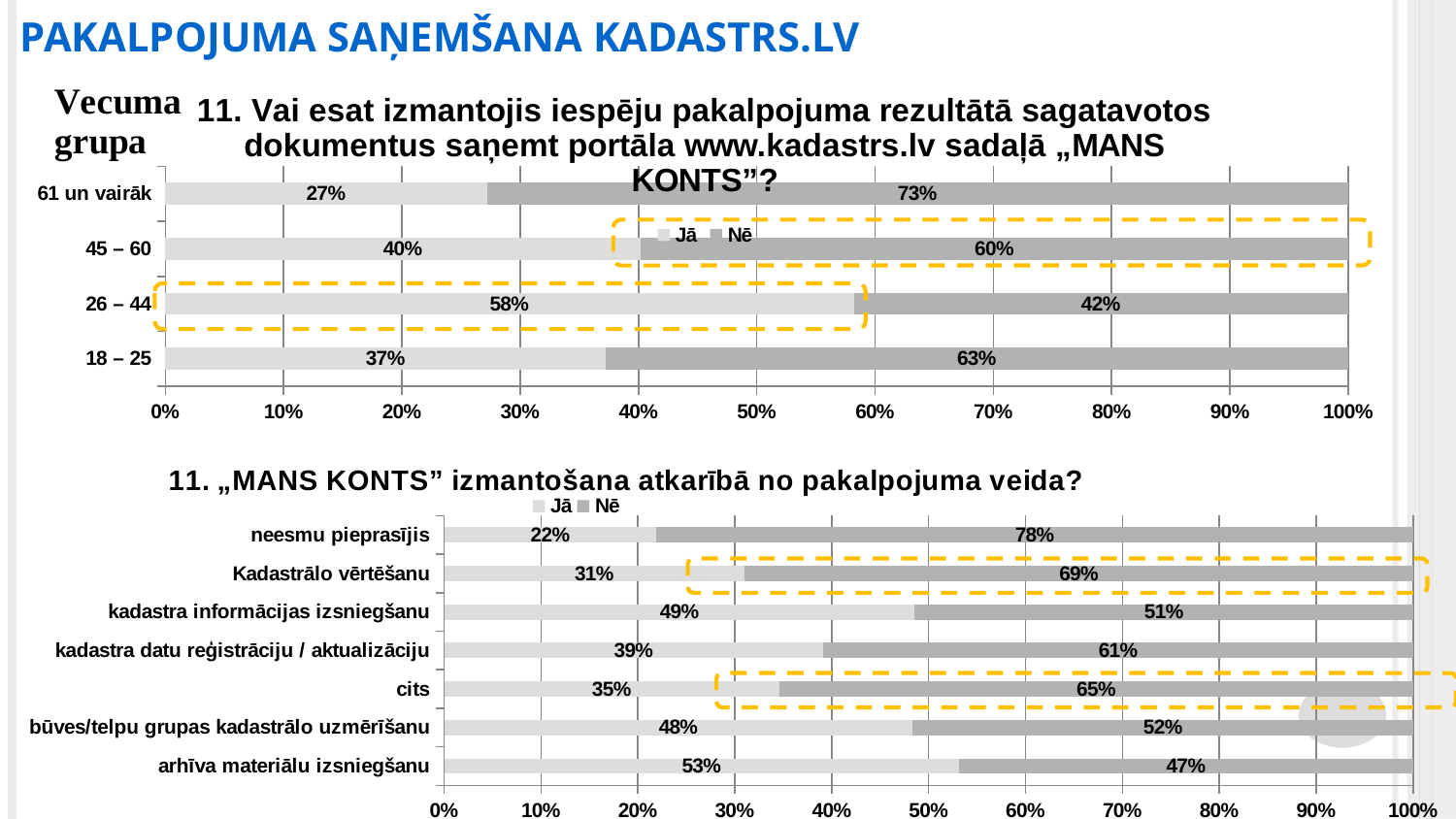
In the bottom chart (by service type), which category has the highest Jā share? arhīva materiālu izsniegšanu In the top chart (by age group), what percentage of the 26 – 44 group answered Jā? 58% In the top chart (by age group), how many age groups are shown? 4 In the bottom chart (by service type), what percentage answered Nē for cits? 65% In the bottom chart (by service type), which category has the lowest Jā share? neesmu pieprasījis In the top chart (by age group), which age group has the highest Jā share? 26 – 44 In the bottom chart (by service type), how many series does the legend list? 2 In the top chart (by age group), which age group has the lowest Jā share? 61 un vairāk What type of chart is the bottom chart (by service type)? Stacked bar chart In the top chart (by age group), what percentage of the 61 un vairāk group answered Nē? 73% In the top chart (by age group), what is the difference between the Nē shares of the 18 – 25 and 45 – 60 groups? 3 percentage points In the bottom chart (by service type), what percentage answered Jā for Kadastrālo vērtēšanu? 31%